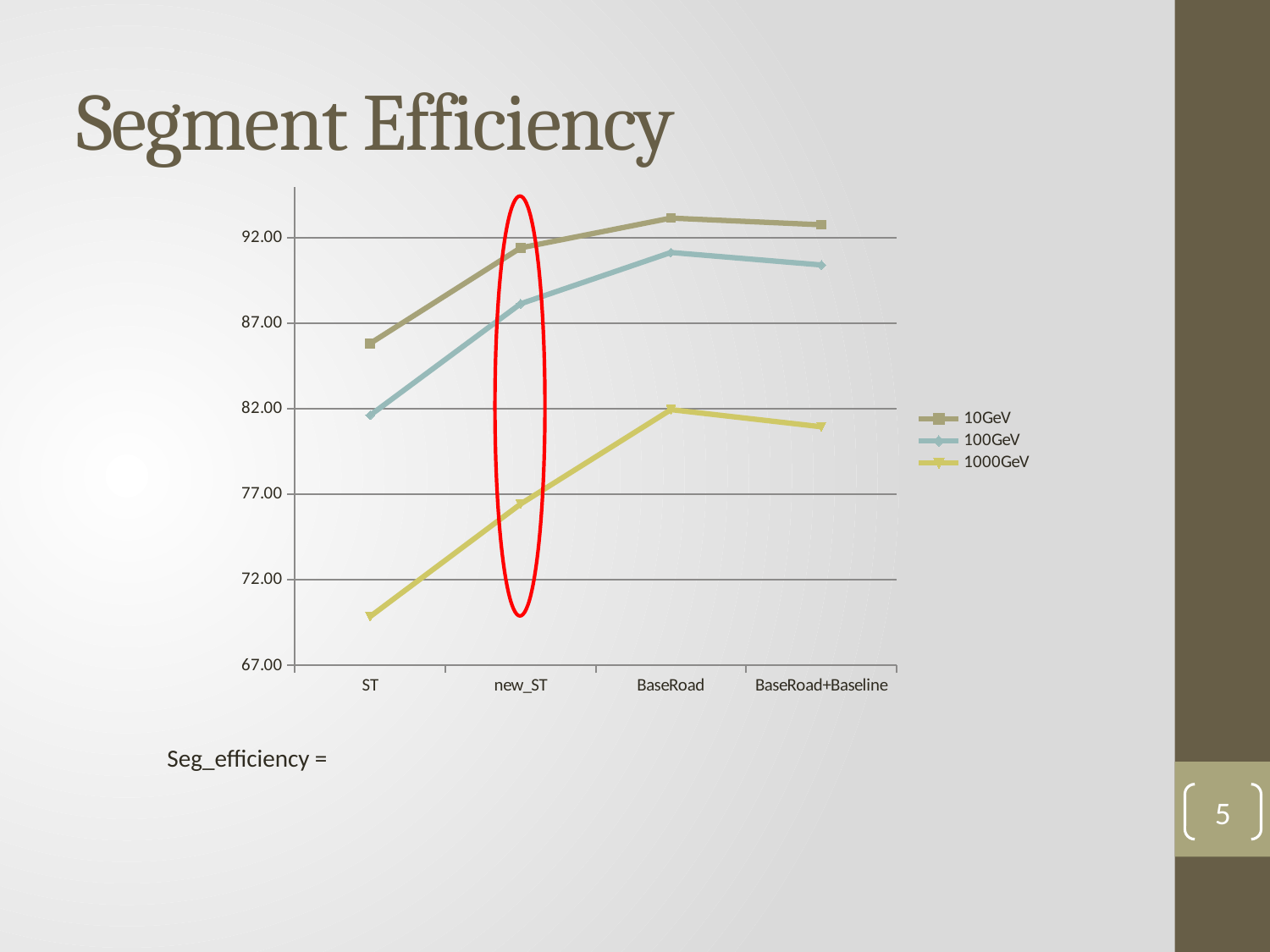
Which series is plotted with the yellow line? 1000GeV Which series has the highest value at ST? 10GeV Which series has the lowest values across all categories? 1000GeV Is the value for 100GeV at new_ST greater or less than 87.00? greater Is the value for 10GeV at ST greater or less than 87.00? less Does the 1000GeV series rise or fall from ST to BaseRoad? rise How many series does the legend list? 3 How many categories are shown on the x axis? 4 Is the value for 1000GeV at ST greater or less than 72.00? less What kind of chart is shown on the slide? line chart For the 1000GeV series, which category has the lowest value? ST What is the title of the chart? Segment Efficiency